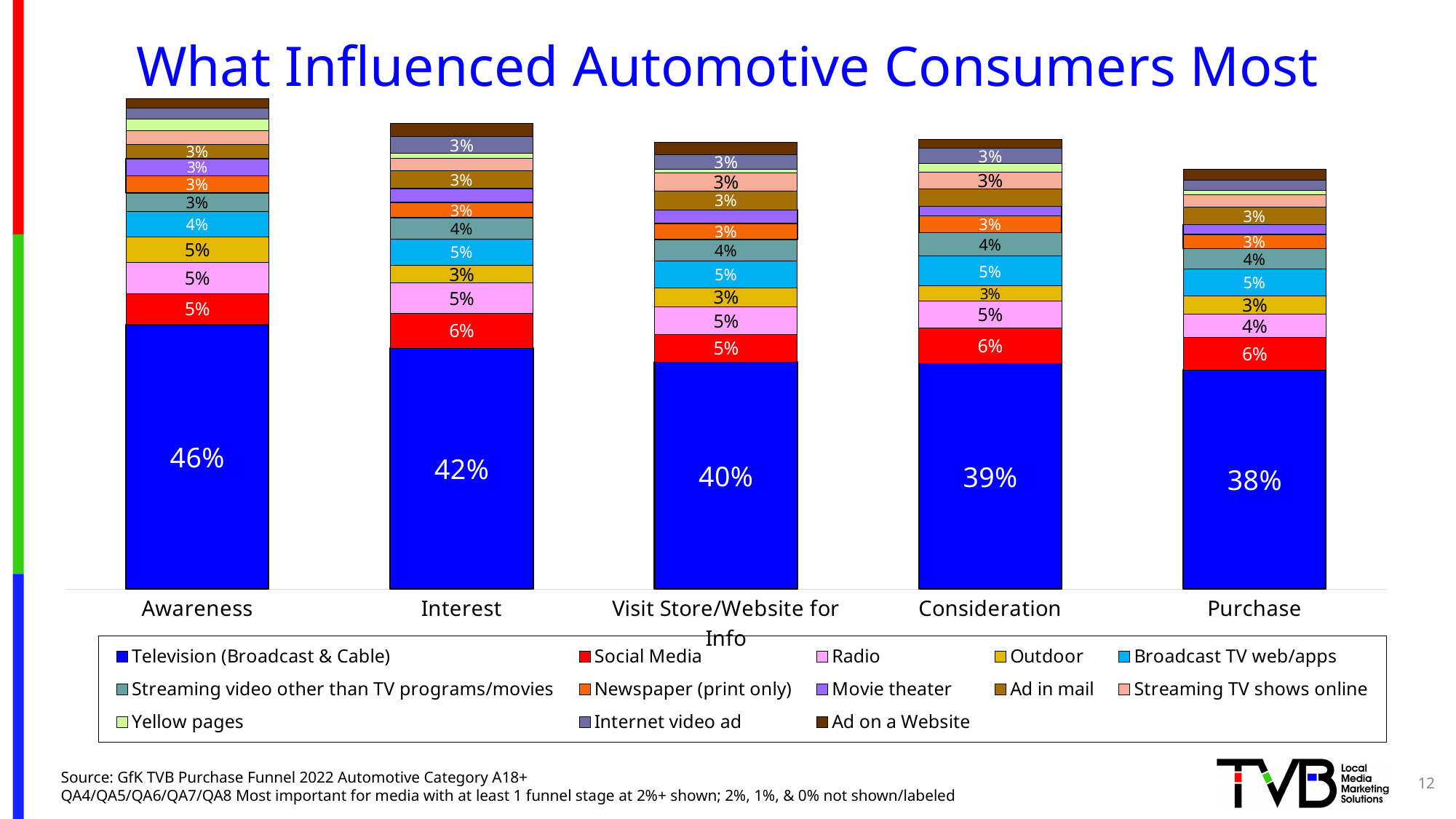
At which funnel stage is the Television (Broadcast & Cable) share lowest? Purchase What percentage is shown for Television (Broadcast & Cable) at the Purchase stage? 38% What percentage is shown for Social Media at the Interest stage? 6% What kind of chart is shown on the slide? Stacked bar chart What percentage is shown for Television (Broadcast & Cable) at the Awareness stage? 46% How many funnel stages are shown along the x axis? 5 What percentage is shown for Outdoor at the Awareness stage? 5% What is the difference in percentage points between the Television (Broadcast & Cable) value at Awareness and at Purchase? 8 percentage points Is the Social Media value larger at Awareness or at Interest? Interest How many media types does the legend list? 13 At which funnel stage is the Television (Broadcast & Cable) share highest? Awareness Does the Television (Broadcast & Cable) value rise or fall moving from Awareness to Purchase? Fall